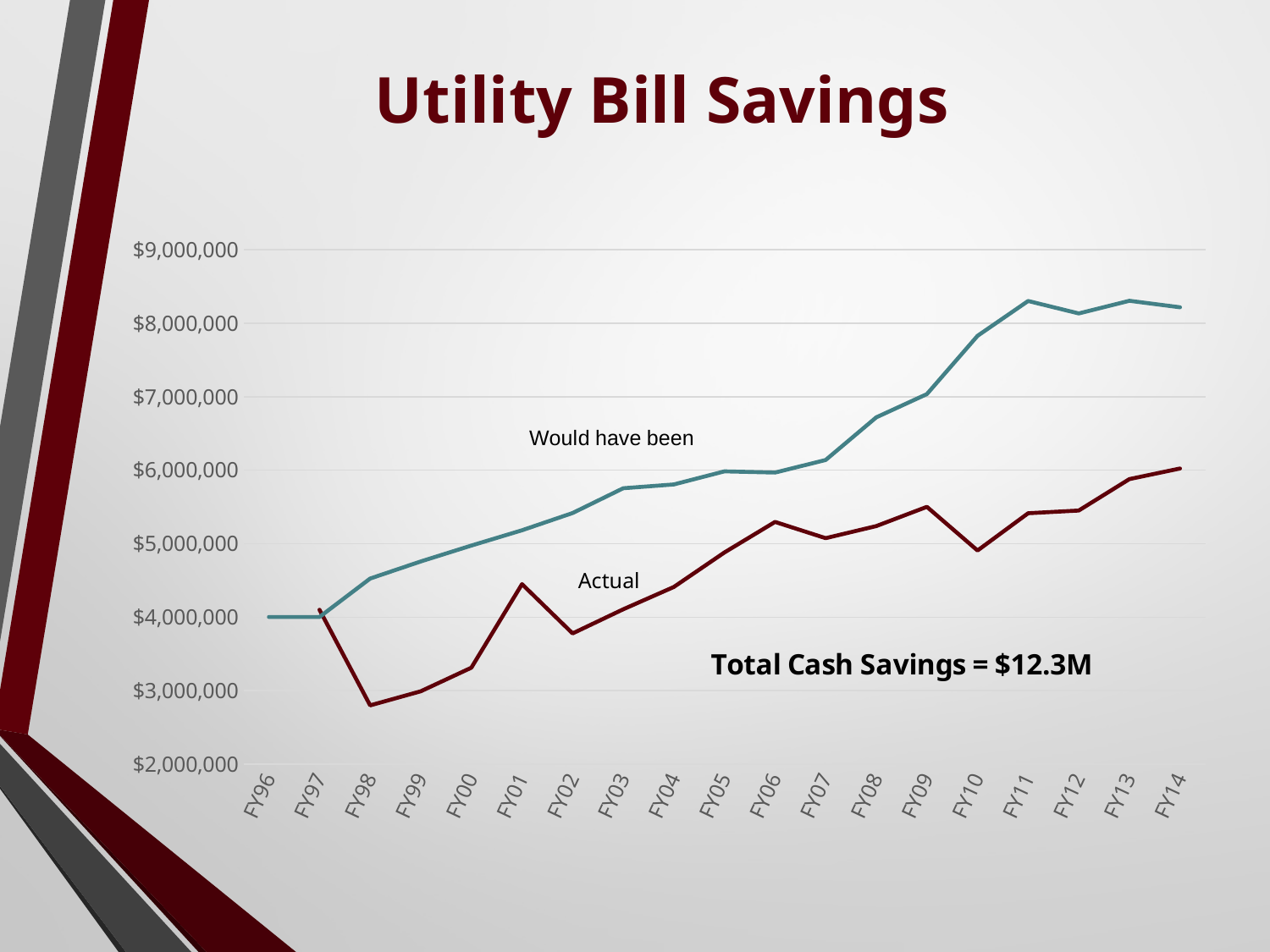
In which fiscal year is the Actual line at its highest? FY14 What are the names of the two series labelled on the chart? Would have been; Actual In which fiscal year is the Actual line at its lowest? FY98 In FY10, which line has the larger value, Would have been or Actual? Would have been Is the value of the Would have been line for FY08 greater or less than $7,000,000? less How many lines (series) are plotted on the chart? 2 Is the value of the Would have been line for FY14 greater or less than $8,000,000? greater Does the Would have been line generally rise or fall from FY96 to FY14? rise How many fiscal years are plotted along the x axis? 19 What is the title of the chart? Utility Bill Savings What kind of chart is shown on the slide? line chart Is the value of the Actual line for FY98 greater or less than $3,000,000? less